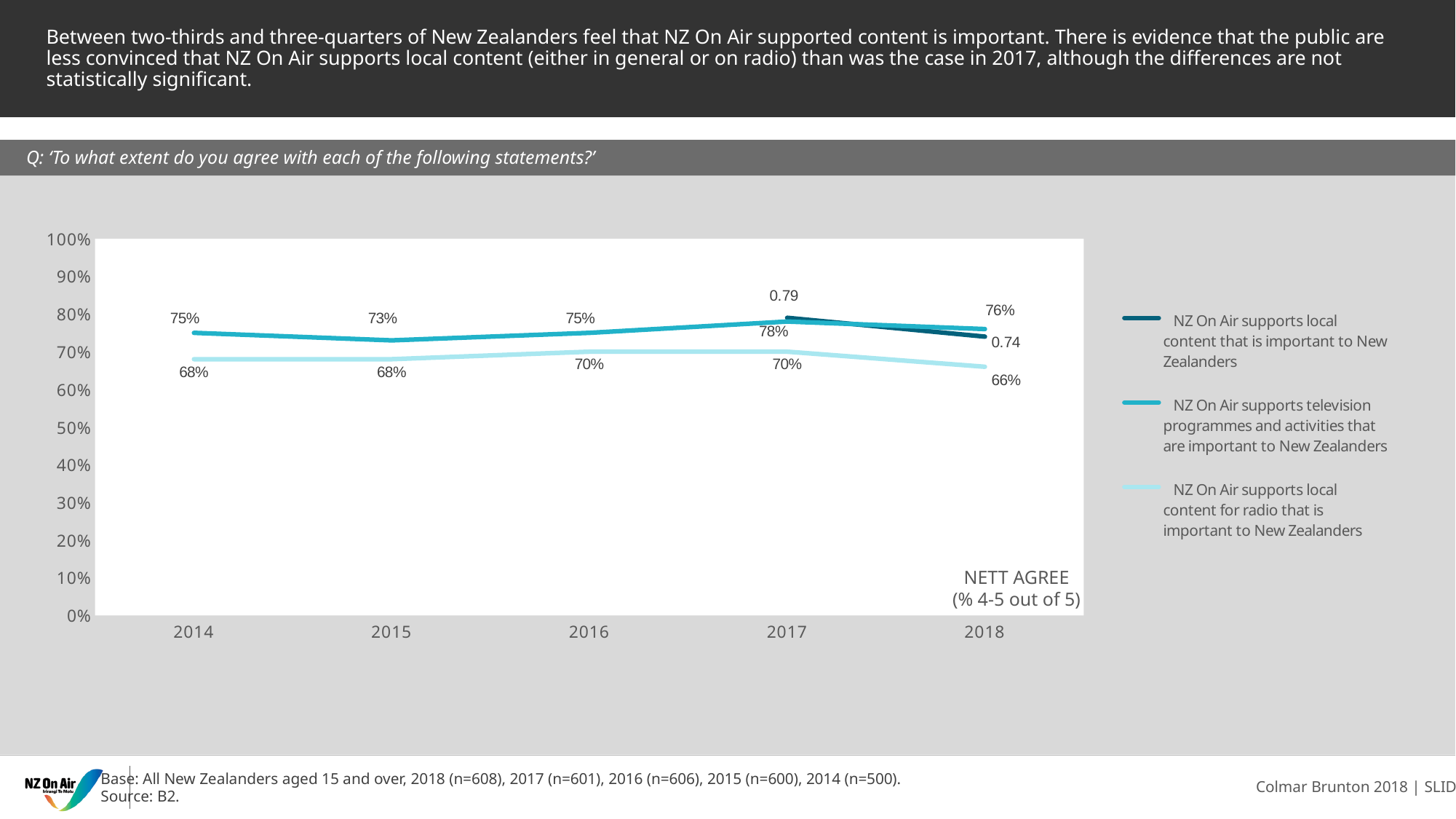
What value is labelled for 'NZ On Air supports local content that is important to New Zealanders' in 2017? 0.79 How many years are shown on the x axis? 5 What kind of chart is shown on the slide? line chart What is the value for 'NZ On Air supports television programmes and activities that are important to New Zealanders' in 2015? 73% Does the 'NZ On Air supports local content for radio that is important to New Zealanders' series rise or fall from 2017 to 2018? fall What is the value for 'NZ On Air supports television programmes and activities that are important to New Zealanders' in 2017? 78% In 2016, which is larger: the television programmes series or the radio series? the television programmes series In which year is the 'NZ On Air supports television programmes and activities that are important to New Zealanders' series highest? 2017 How many series does the legend list? 3 What is the difference between the television programmes series and the radio series in 2018? 10% What is the value for 'NZ On Air supports local content for radio that is important to New Zealanders' in 2018? 66% In which year is the 'NZ On Air supports local content for radio that is important to New Zealanders' series lowest? 2018